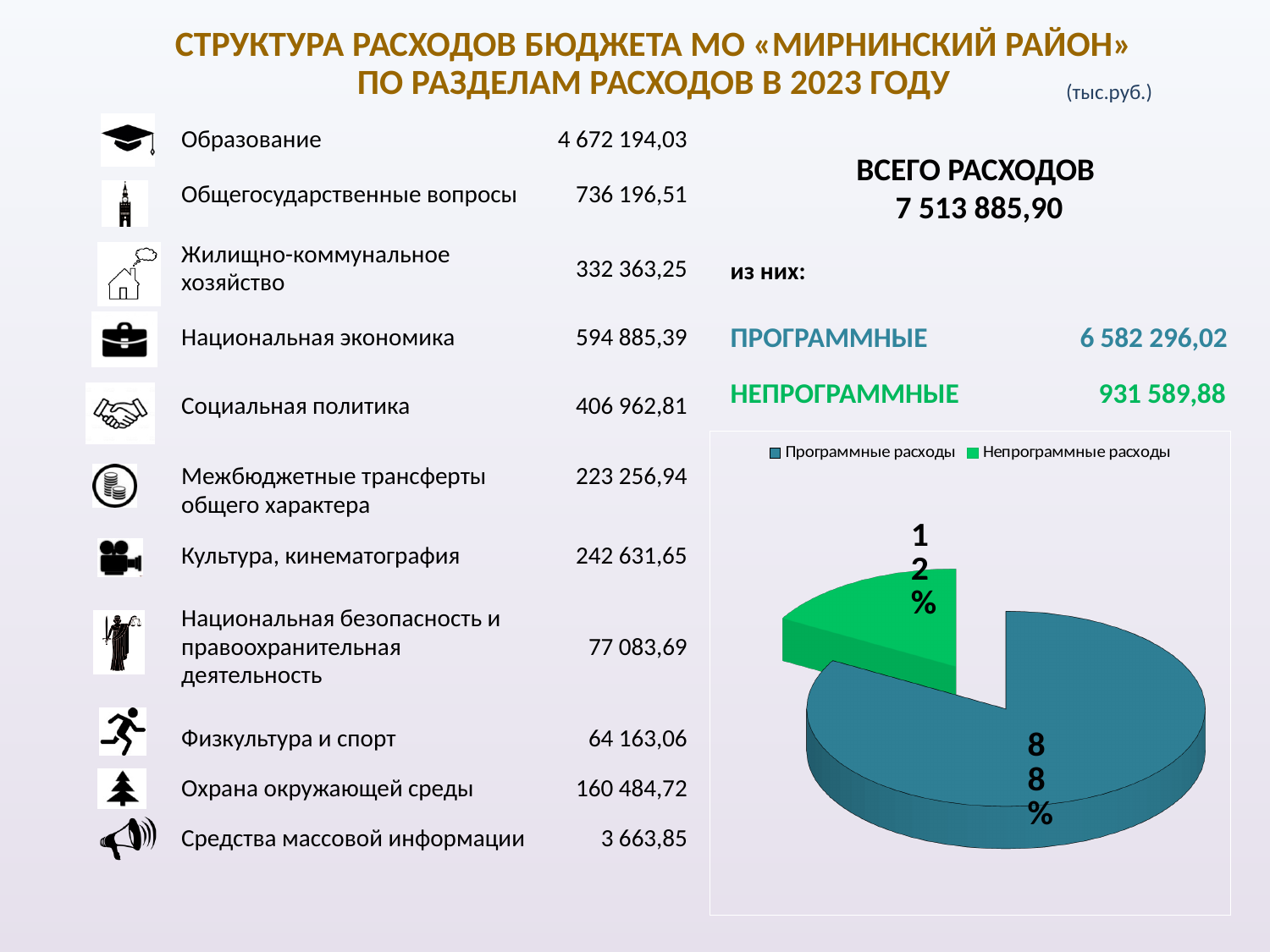
Which slice of the pie chart is the largest? Программные расходы What colour is the Непрограммные расходы slice in the pie chart? green Which slice of the pie chart is the smallest? Непрограммные расходы What share of the pie chart is Непрограммные расходы? 12% What share of the pie chart is Программные расходы? 88% Which is larger in the pie chart, Программные расходы or Непрограммные расходы? Программные расходы What colour is the Программные расходы slice in the pie chart? blue How many series does the legend of the pie chart list? 2 What is the difference in percentage points between the Программные расходы and Непрограммные расходы slices of the pie chart? 76 What kind of chart is shown on the slide? pie chart How many slices does the pie chart have? 2